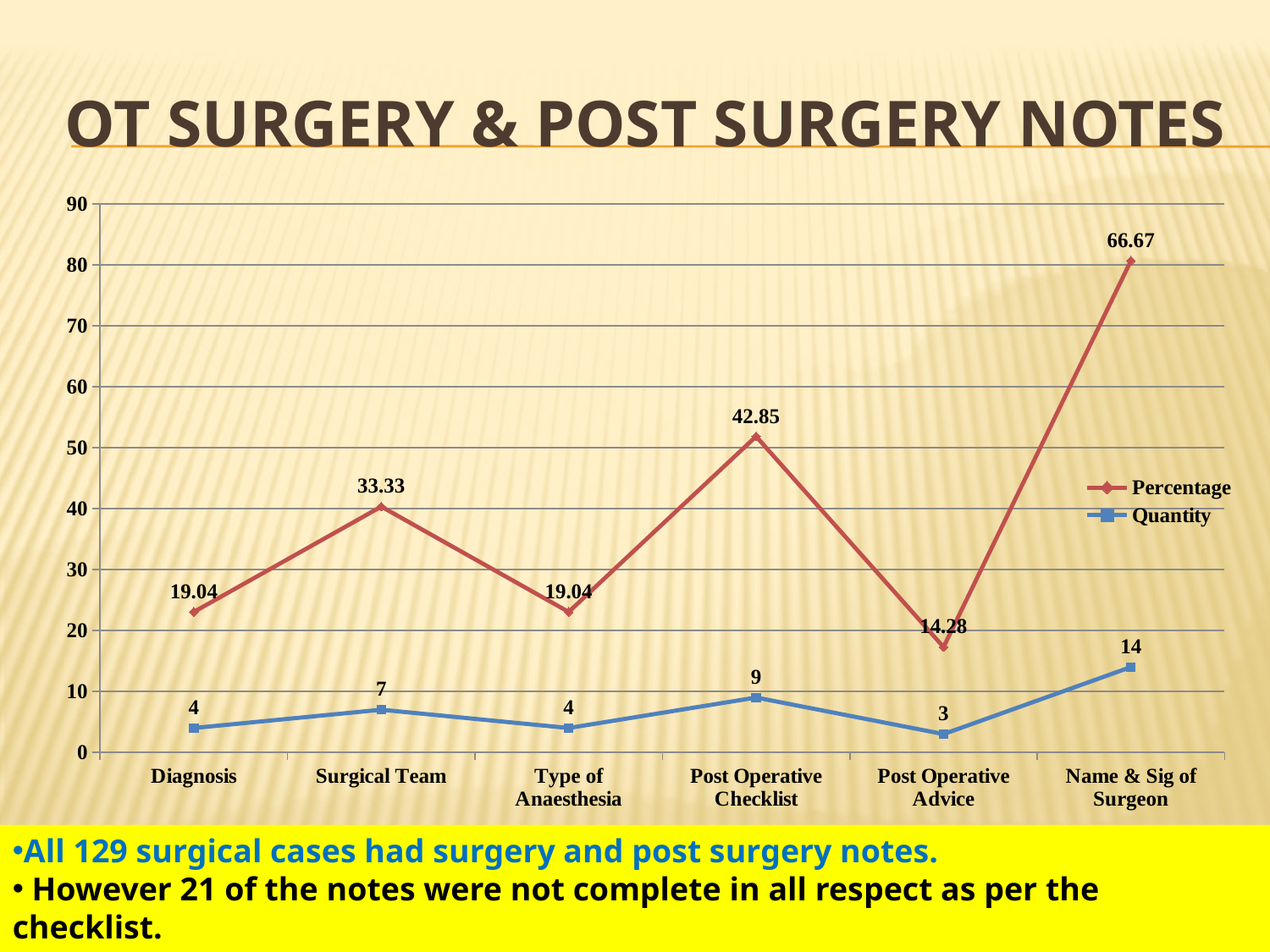
What is the Percentage value for Post Operative Checklist? 42.85 How many series does the legend list? 2 What is the Quantity value for Surgical Team? 7 How many categories are shown on the x axis? 6 Does the Quantity series rise or fall from Post Operative Advice to Name & Sig of Surgeon? Rise Which is larger, the Percentage value for Surgical Team or for Post Operative Advice? Surgical Team What is the difference between the Quantity values for Name & Sig of Surgeon and Post Operative Advice? 11 Which category has the highest Percentage value? Name & Sig of Surgeon What kind of chart is shown on the slide? Line chart Which category has the lowest Quantity value? Post Operative Advice What is the Quantity value for Name & Sig of Surgeon? 14 What is the title of the slide containing the chart? OT SURGERY & POST SURGERY NOTES